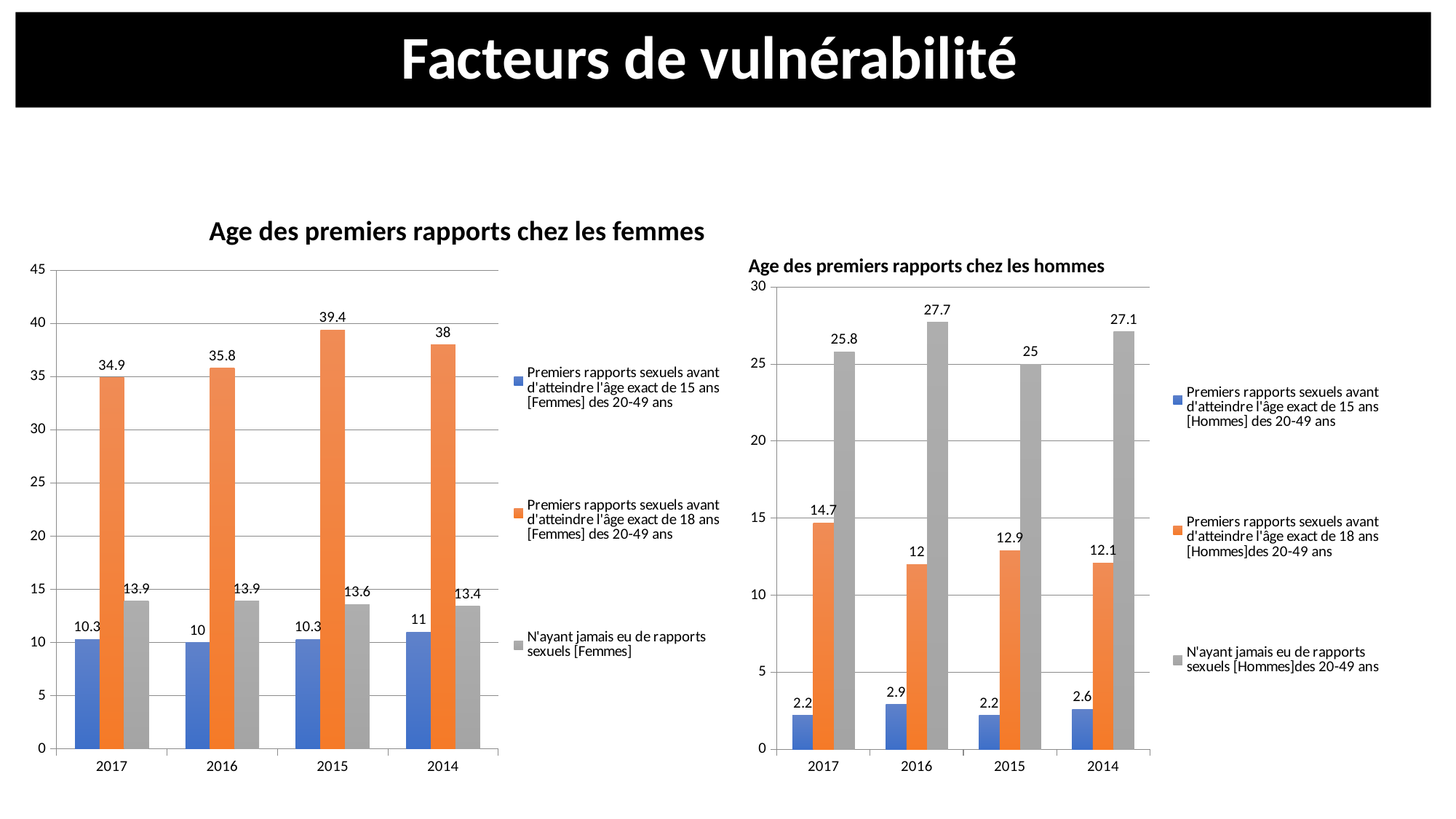
How many series does the legend of the chart 'Age des premiers rapports chez les femmes' list? 3 In the chart 'Age des premiers rapports chez les femmes', what is the difference between the 2015 and 2017 values for 'Premiers rapports sexuels avant d'atteindre l'âge exact de 18 ans [Femmes] des 20-49 ans'? 4.5 What is the title of the chart on the left of the slide? Age des premiers rapports chez les femmes In the chart 'Age des premiers rapports chez les femmes', which year has the highest value for 'Premiers rapports sexuels avant d'atteindre l'âge exact de 18 ans [Femmes] des 20-49 ans'? 2015 What kind of chart is 'Age des premiers rapports chez les hommes'? Bar chart In the chart 'Age des premiers rapports chez les hommes', which year has the lowest value for 'N'ayant jamais eu de rapports sexuels [Hommes]des 20-49 ans'? 2015 In the chart 'Age des premiers rapports chez les hommes', which is larger: the 2017 or the 2016 value for 'Premiers rapports sexuels avant d'atteindre l'âge exact de 18 ans [Hommes]des 20-49 ans'? 2017 In the chart 'Age des premiers rapports chez les hommes', what is the value for 'Premiers rapports sexuels avant d'atteindre l'âge exact de 15 ans [Hommes] des 20-49 ans' in 2014? 2.6 How many years are shown on the x axis of the chart 'Age des premiers rapports chez les hommes'? 4 In the chart 'Age des premiers rapports chez les femmes', is the 2014 value for 'Premiers rapports sexuels avant d'atteindre l'âge exact de 18 ans [Femmes] des 20-49 ans' greater or less than 35? greater In the chart 'Age des premiers rapports chez les femmes', what is the value for 'Premiers rapports sexuels avant d'atteindre l'âge exact de 18 ans [Femmes] des 20-49 ans' in 2015? 39.4 In the chart 'Age des premiers rapports chez les hommes', what is the value for 'N'ayant jamais eu de rapports sexuels [Hommes]des 20-49 ans' in 2016? 27.7